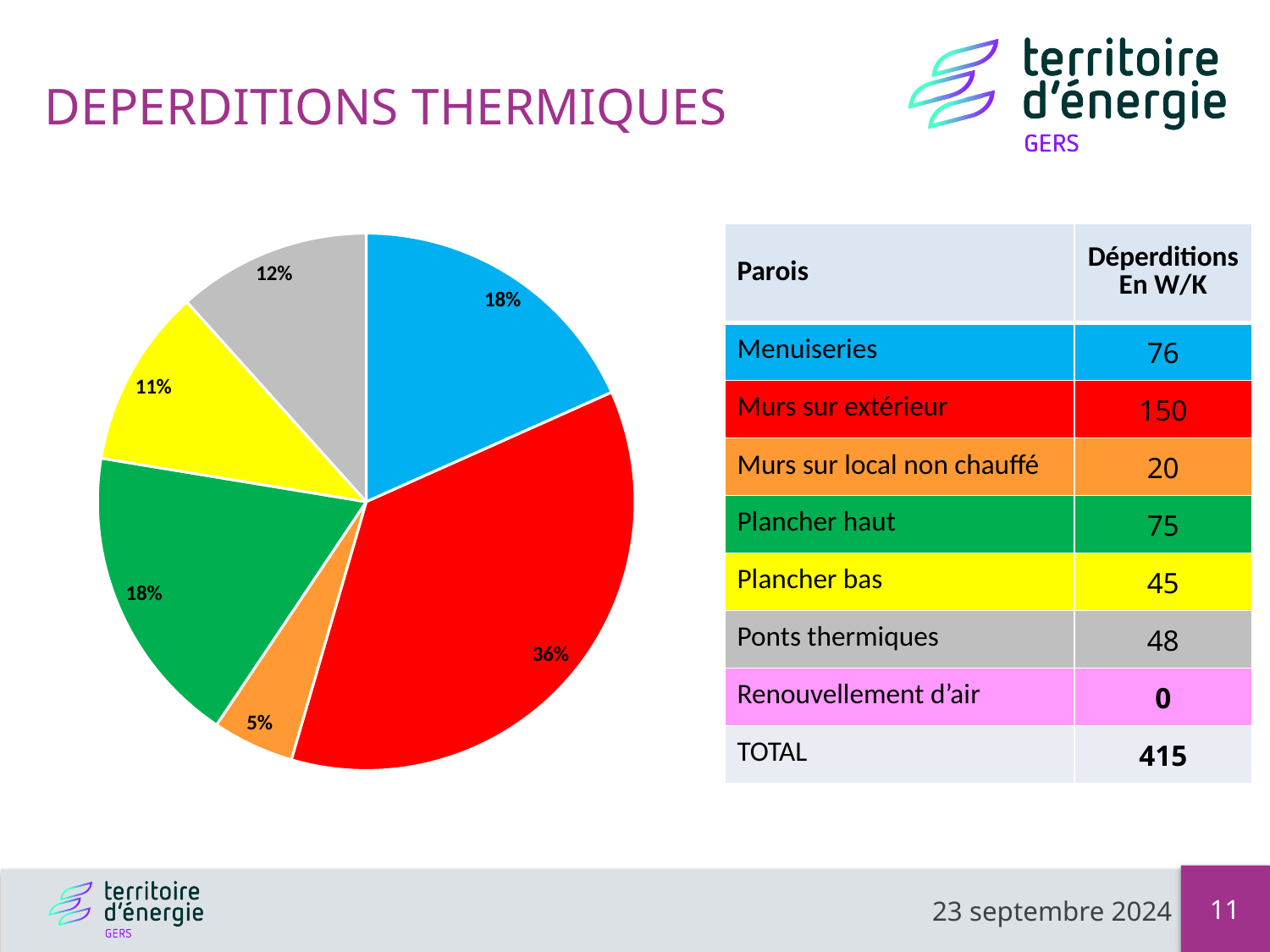
What kind of chart is shown on the slide? pie chart What colour is the slice representing Plancher haut in the pie chart? green What percentage is shown on the orange slice of the pie chart? 5% What percentage is shown on the yellow slice of the pie chart? 11% How many slices does the pie chart have? 6 What share of the pie does the red slice (Murs sur extérieur) represent? 36% What percentage is shown on the grey slice of the pie chart? 12% Which slice of the pie chart is the smallest? the orange slice (Murs sur local non chauffé), 5% What percentage is shown on the blue slice of the pie chart? 18% Which slice of the pie chart is the largest? the red slice (Murs sur extérieur), 36% What is the difference in percentage points between the red slice (36%) and the green slice (18%)? 18 Which is larger, the grey slice or the yellow slice? the grey slice (12%)